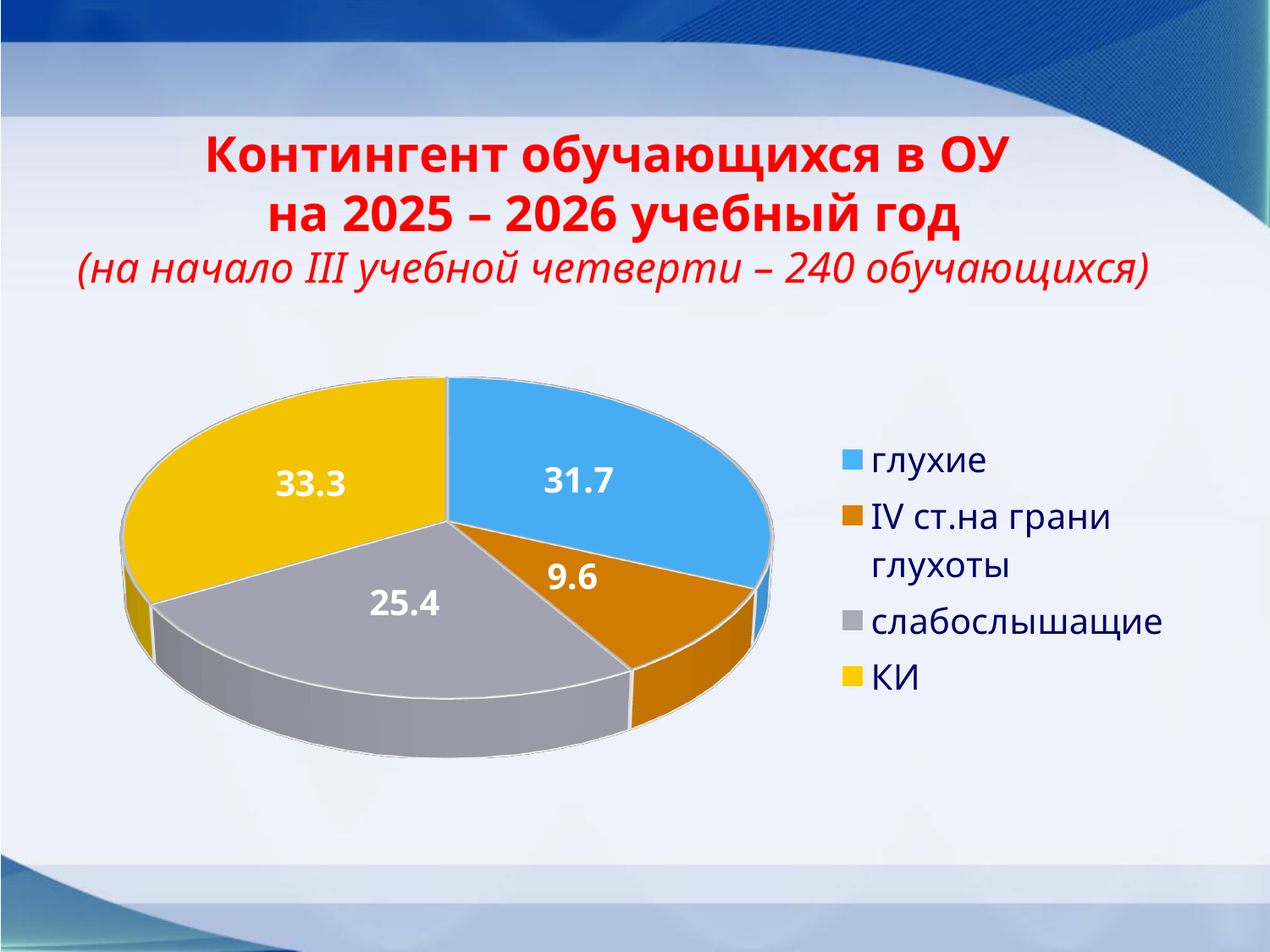
Which category has the largest slice of the pie? КИ Which is larger, the value for глухие or the value for слабослышащие? глухие Which category has the smallest slice of the pie? IV ст.на грани глухоты How many categories does the legend list? 4 What is the value shown for the слабослышащие slice? 25.4 What is the difference between the values for слабослышащие and IV ст.на грани глухоты? 15.8 What is the value shown for the глухие slice? 31.7 What is the difference between the values for КИ and глухие? 1.6 What is the value shown for the IV ст.на грани глухоты slice? 9.6 What is the value shown for the КИ slice? 33.3 What colour is the слабослышащие slice? gray What type of chart is shown on the slide? pie chart